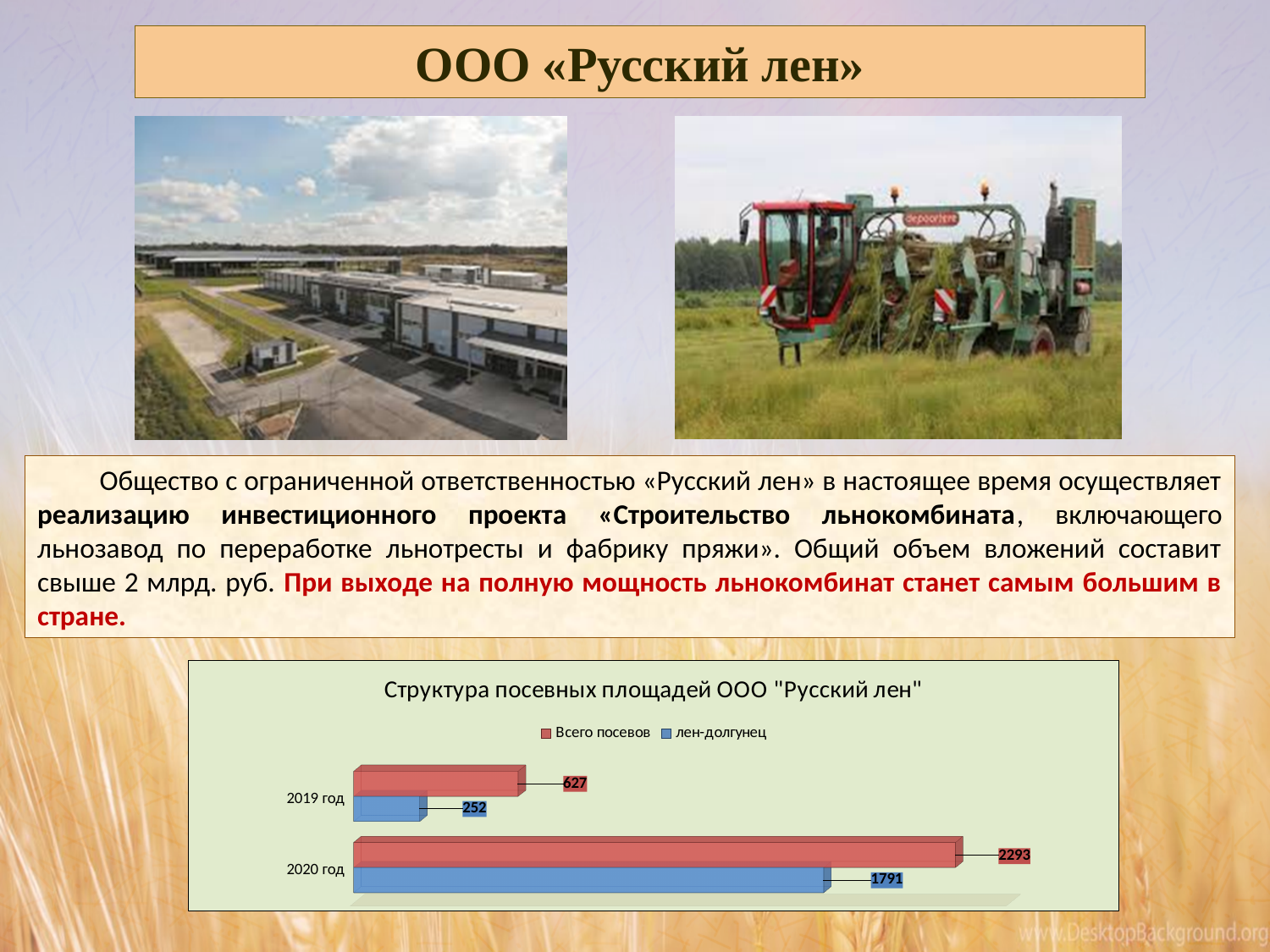
What type of chart is shown on the slide? bar chart Which series is shown in red in the chart? Всего посевов Which year has the higher value for "лен-долгунец"? 2020 год What is the difference between "Всего посевов" and "лен-долгунец" in 2020 год? 502 How many categories (years) are shown on the chart? 2 What is the value of "Всего посевов" for 2020 год? 2293 What is the value of "лен-долгунец" for 2019 год? 252 What is the difference between "Всего посевов" in 2020 год and in 2019 год? 1666 How many series does the chart legend list? 2 What is the value of "лен-долгунец" for 2020 год? 1791 What is the value of "Всего посевов" for 2019 год? 627 What is the title of the chart on the slide? Структура посевных площадей ООО "Русский лен"